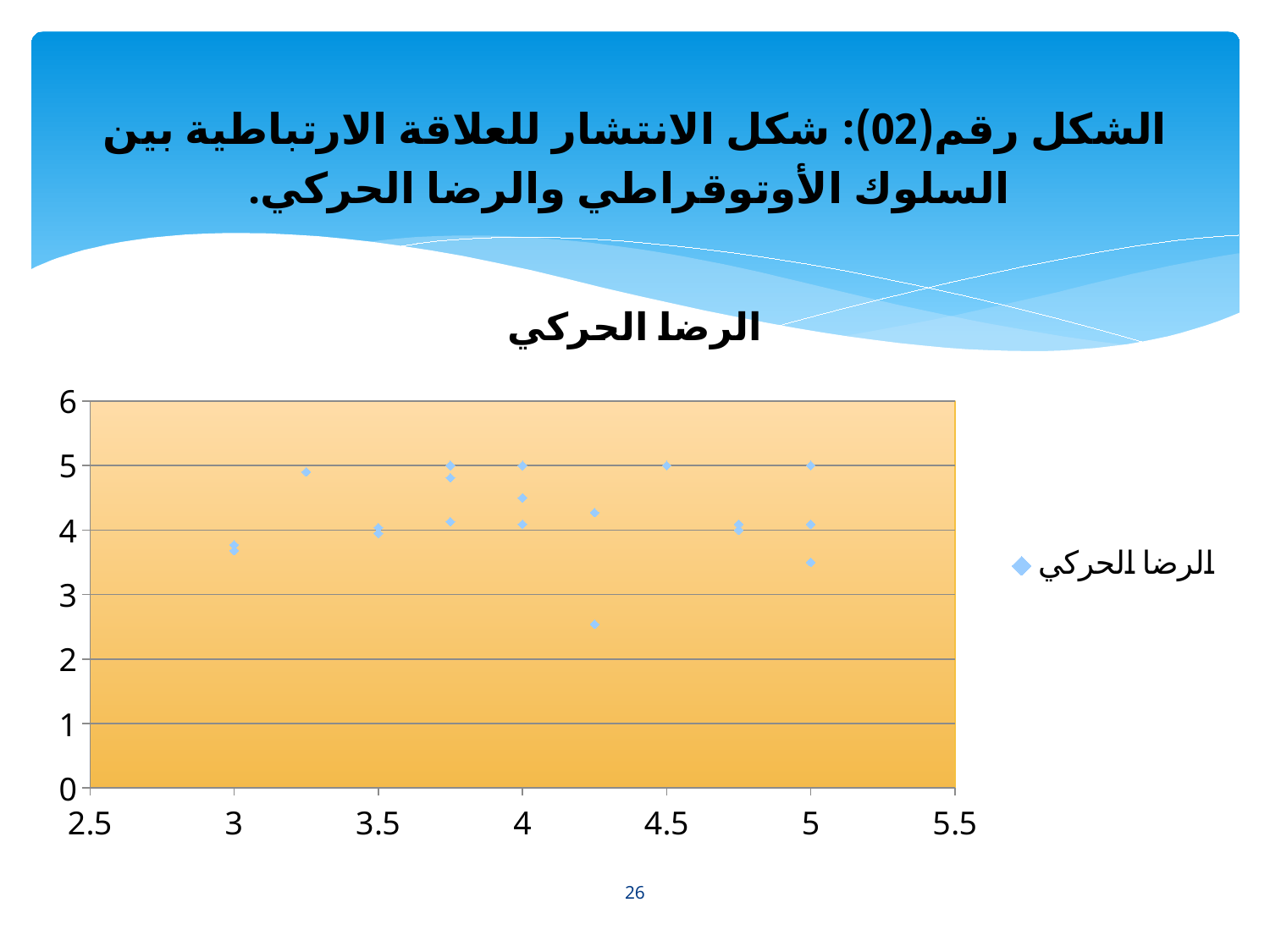
What is the highest y value reached by any point in the chart? 5 Is the point at x = 4.5 greater or less than 4 on the y axis? greater How many tick labels are shown on the x axis? 7 What is the title of the chart? الرضا الحركي What kind of chart is shown on the slide? Scatter chart Is the point at x = 3.25 greater or less than 4 on the y axis? greater What is the highest value shown on the y axis? 6 Which has the higher y value: the point at x = 3.25 or the lowest point at x = 4.25? The point at x = 3.25 How many series does the legend list? 1 What is the lowest value shown on the x axis? 2.5 Is the lowest point in the chart greater or less than 3 on the y axis? less